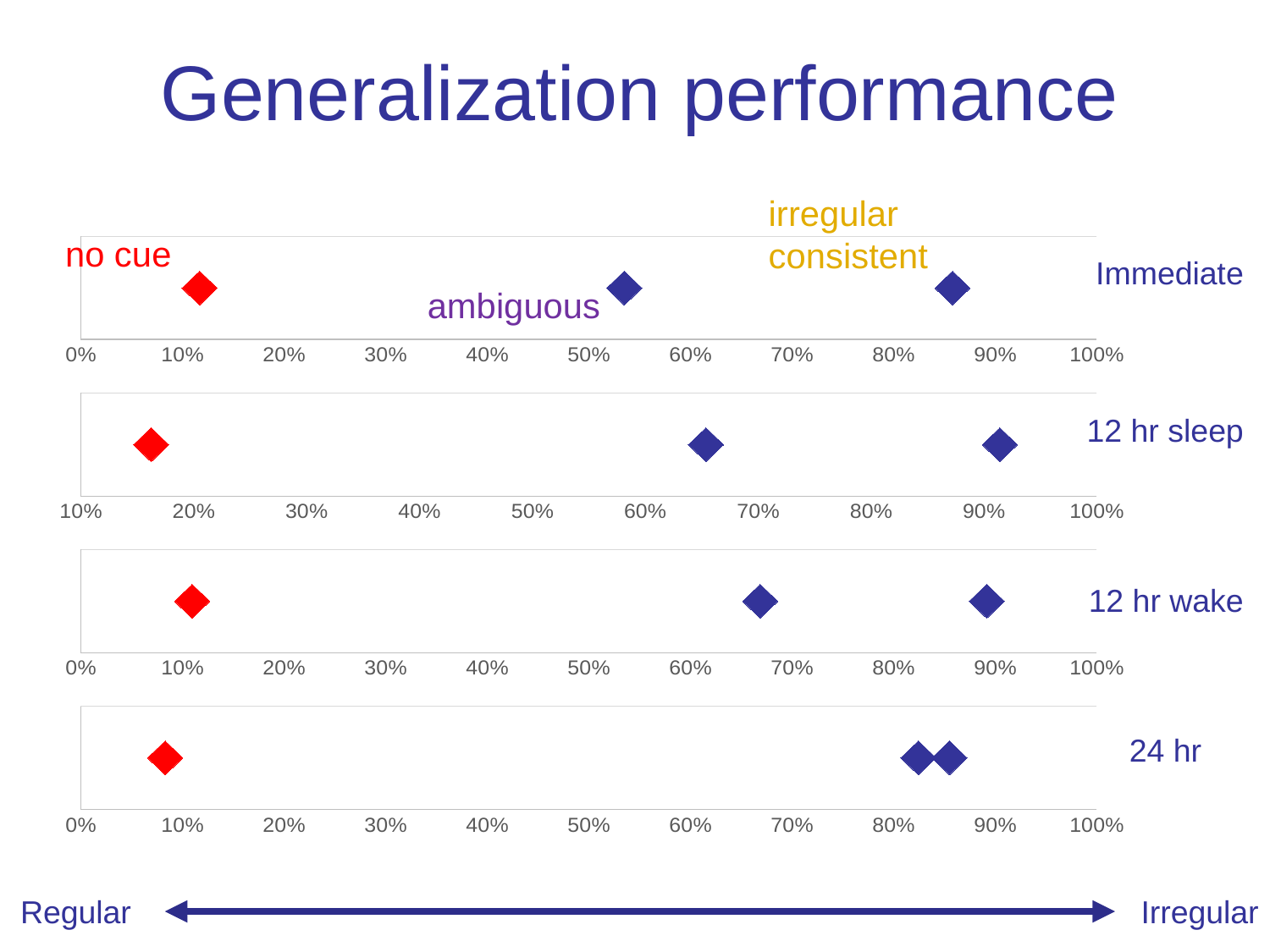
In the 'Immediate' chart, which condition has the highest value? irregular consistent In the 'Immediate' chart, is the value for 'ambiguous' greater or less than 50%? greater In the '12 hr wake' chart, is the value for the rightmost blue point greater or less than 80%? greater In the 'Immediate' chart, is the value for 'no cue' greater or less than 20%? less In the 'Immediate' chart, which condition has the lowest value? no cue How many data points are plotted in the 'Immediate' chart? 3 What kind of chart is the 'Immediate' chart? scatter chart What is the title of the slide containing these charts? Generalization performance